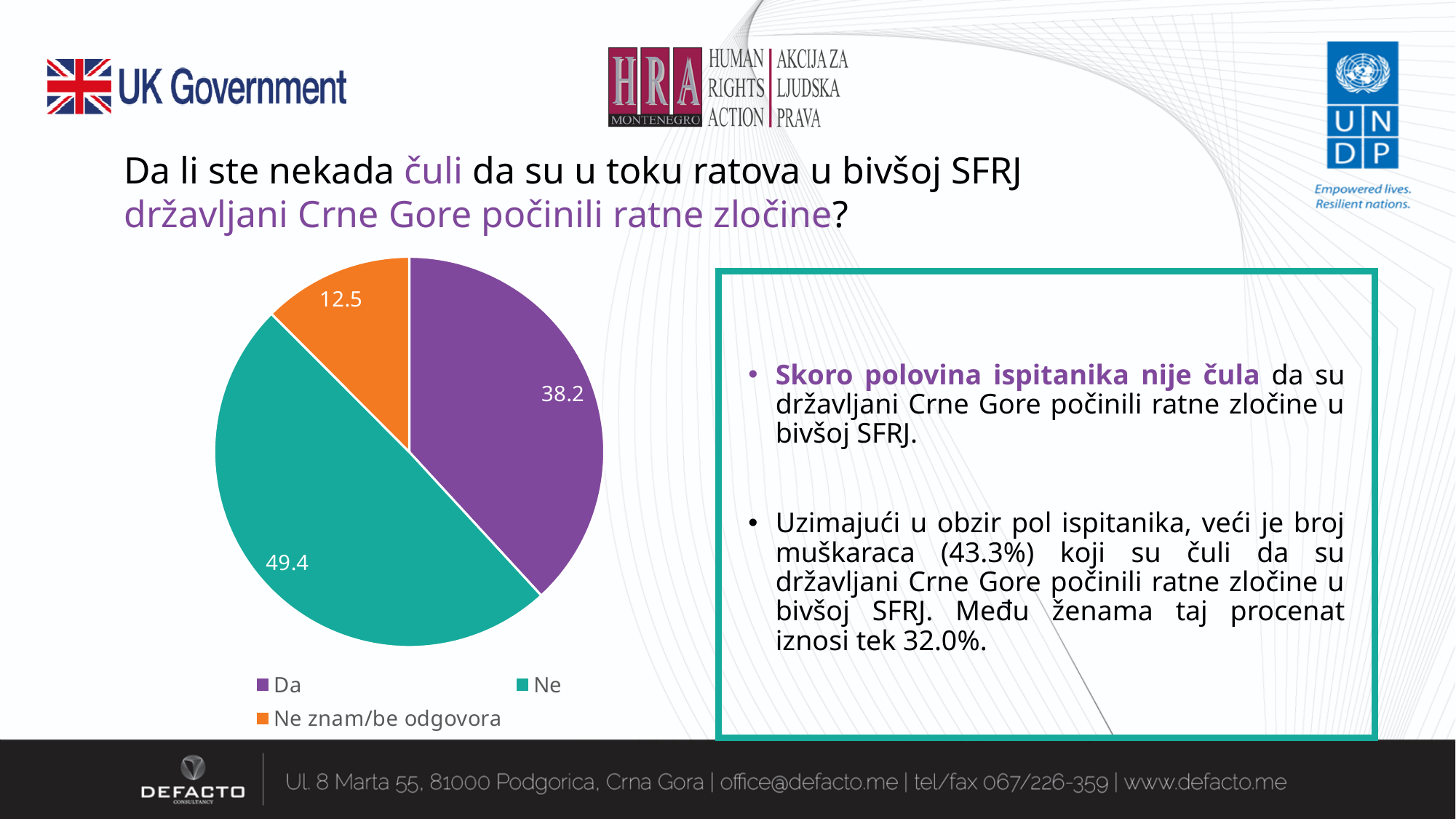
What is the value for the 'Ne' slice? 49.4 How many slices does the pie chart have? 3 Which category has the smallest slice? Ne znam/be odgovora What is the difference between the 'Ne' and 'Da' values? 11.2 How many entries does the legend list? 3 What is the value for the 'Da' slice? 38.2 Which is larger, the 'Da' slice or the 'Ne' slice? Ne What type of chart is shown on the slide? pie chart What colour is the 'Ne' slice? teal What is the value for the 'Ne znam/be odgovora' slice? 12.5 Which category has the largest slice? Ne What is the difference between the 'Da' and 'Ne znam/be odgovora' values? 25.7